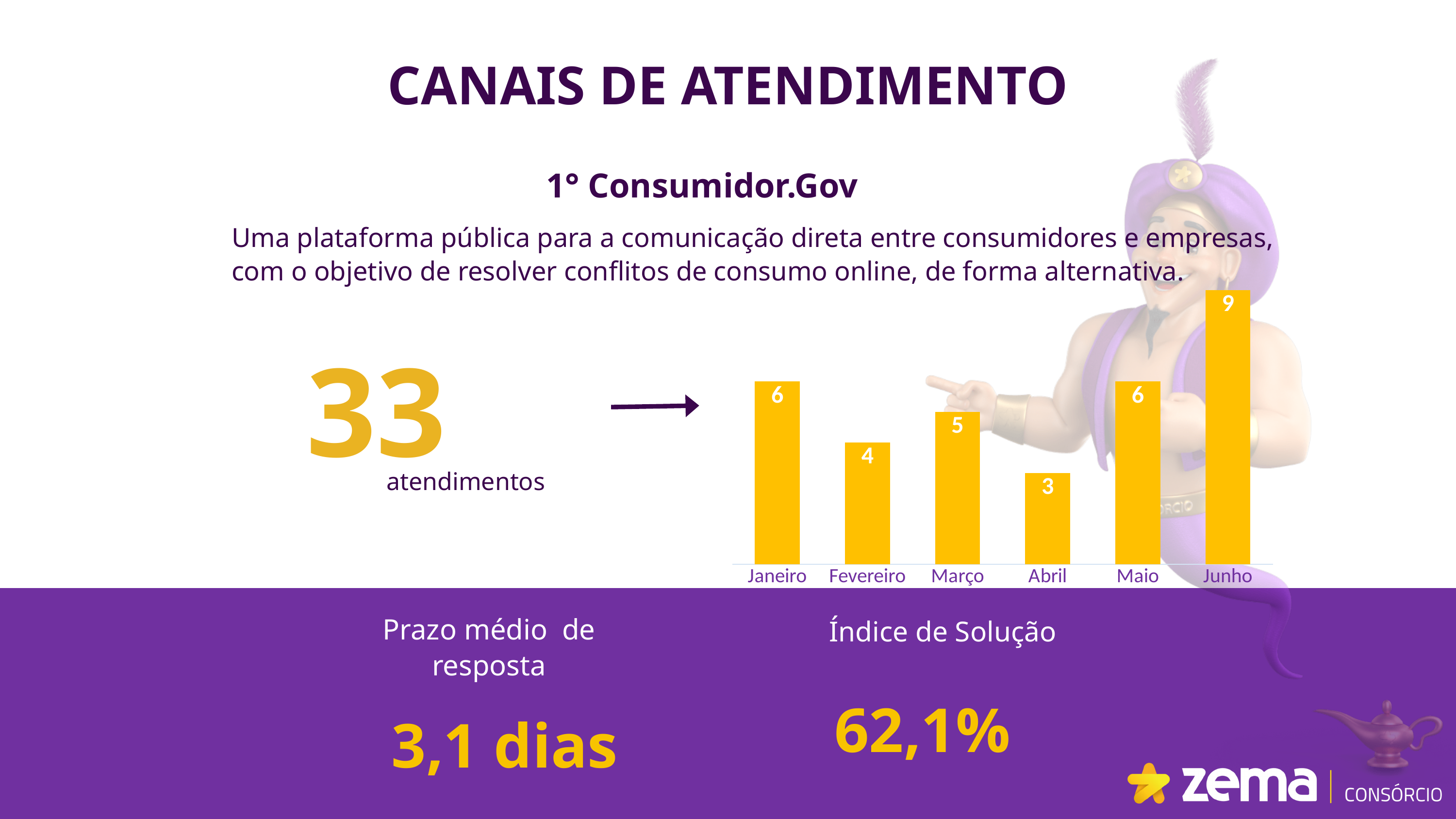
What is the value for Junho? 9 Which month has the lowest value? Abril What kind of chart is shown on the slide? bar chart What colour are the bars in the chart? yellow What is the value for Janeiro? 6 Which month has the highest value? Junho Which is larger, the value for Março or the value for Fevereiro? Março What is the value for Abril? 3 What is the value for Fevereiro? 4 How many months are shown on the chart? 6 What is the difference between the values for Junho and Abril? 6 What is the total of the values for Janeiro, Fevereiro and Março? 15